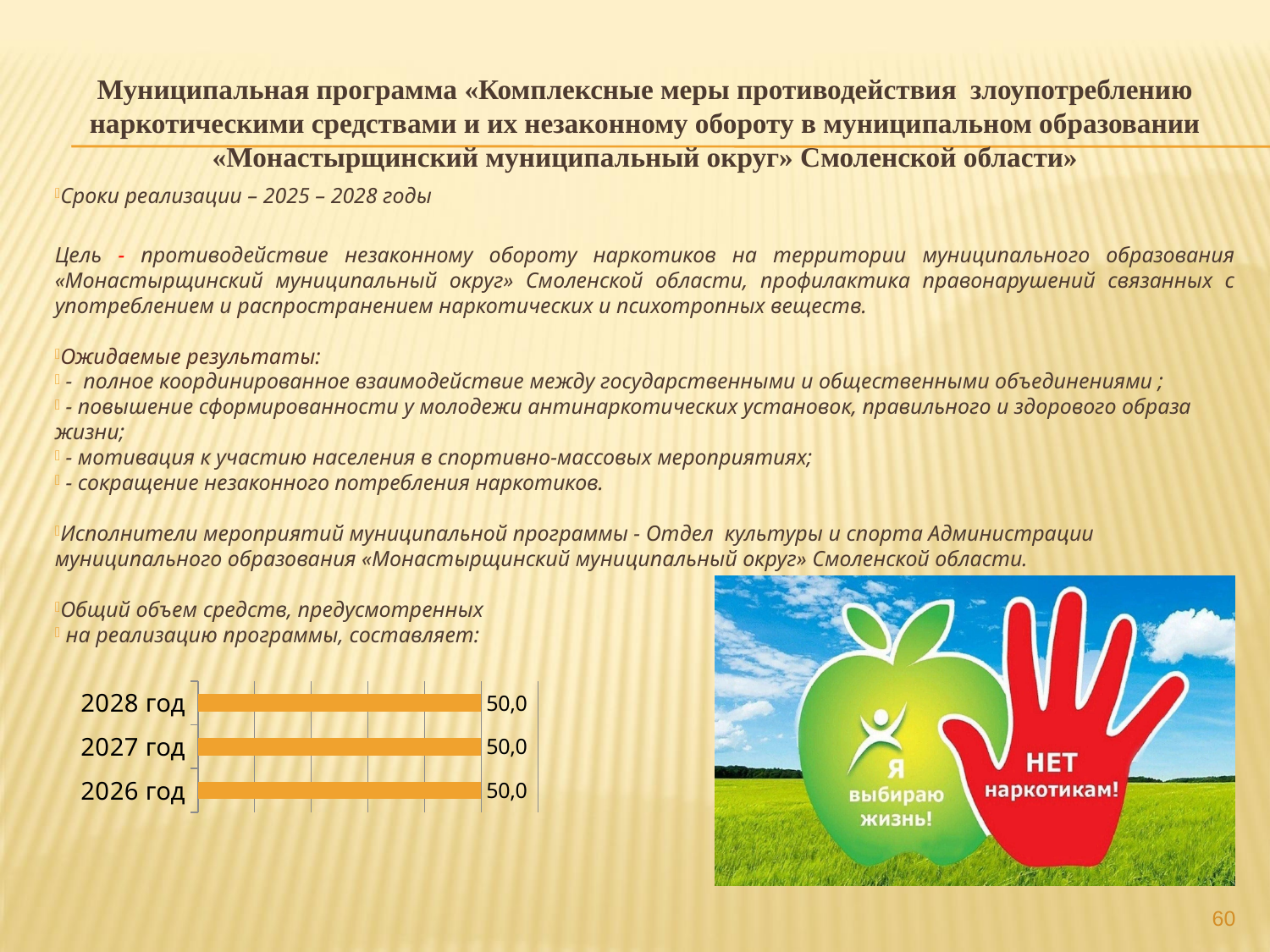
Do the values in the bar chart rise, fall, or stay the same from 2026 год to 2028 год? Stay the same What is the value shown for 2027 год in the bar chart? 50,0 What is the value shown for 2028 год in the bar chart? 50,0 What is the difference between the values for 2028 год and 2026 год in the bar chart? 0,0 How many categories (years) are plotted in the bar chart? 3 What colour are the bars in the bar chart? Orange What is the value shown for 2026 год in the bar chart? 50,0 What kind of chart is shown at the bottom left of the slide? Bar chart Which years are listed as categories in the bar chart? 2026 год, 2027 год, 2028 год